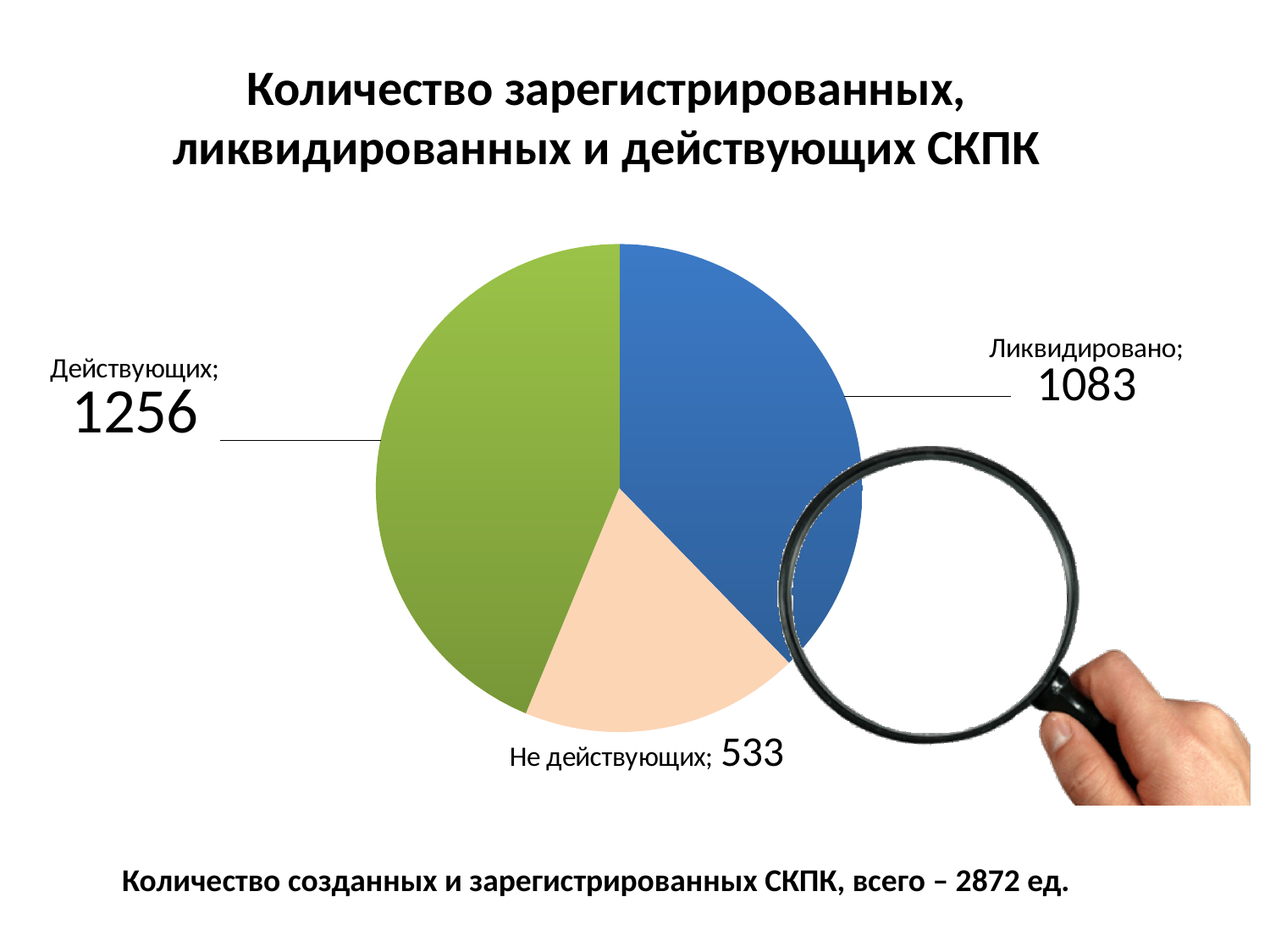
What is the value for "Действующих" in the pie chart? 1256 What is the value for "Ликвидировано" in the pie chart? 1083 Which is larger, the value for "Ликвидировано" or the value for "Не действующих"? Ликвидировано How many slices does the pie chart have? 3 What kind of chart is shown on the slide? pie chart What colour is the "Действующих" slice in the pie chart? green Which category has the largest slice in the pie chart? Действующих What is the value for "Не действующих" in the pie chart? 533 What is the difference between the values for "Ликвидировано" and "Не действующих"? 550 What is the total of all slices in the pie chart? 2872 What is the difference between the values for "Действующих" and "Ликвидировано"? 173 Which category has the smallest slice in the pie chart? Не действующих